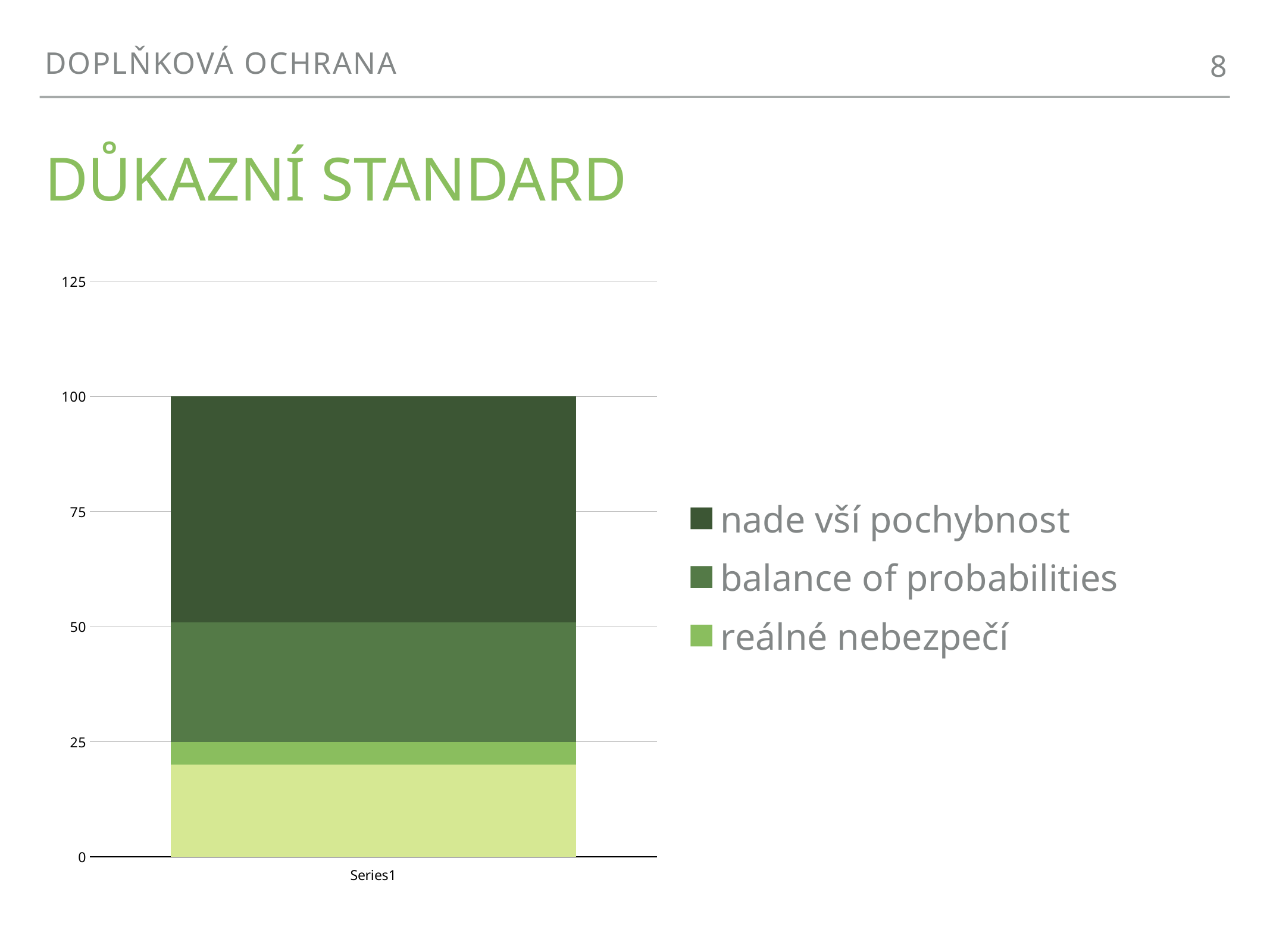
What is the highest value shown on the y axis? 125 Which is larger, the segment for nade vší pochybnost or the segment for balance of probabilities? nade vší pochybnost Is the value for nade vší pochybnost greater or less than 75? less What kind of chart is shown on the slide? stacked bar chart What is the total height of the stacked bar for Series1? 100 Is the value for nade vší pochybnost greater or less than 25? greater How many series does the legend list? 3 Which series is shown in the darkest green in the legend? nade vší pochybnost How many categories are plotted on the x axis? 1 What is the label of the single category on the x axis? Series1 Which series occupies the largest segment of the stacked bar? nade vší pochybnost